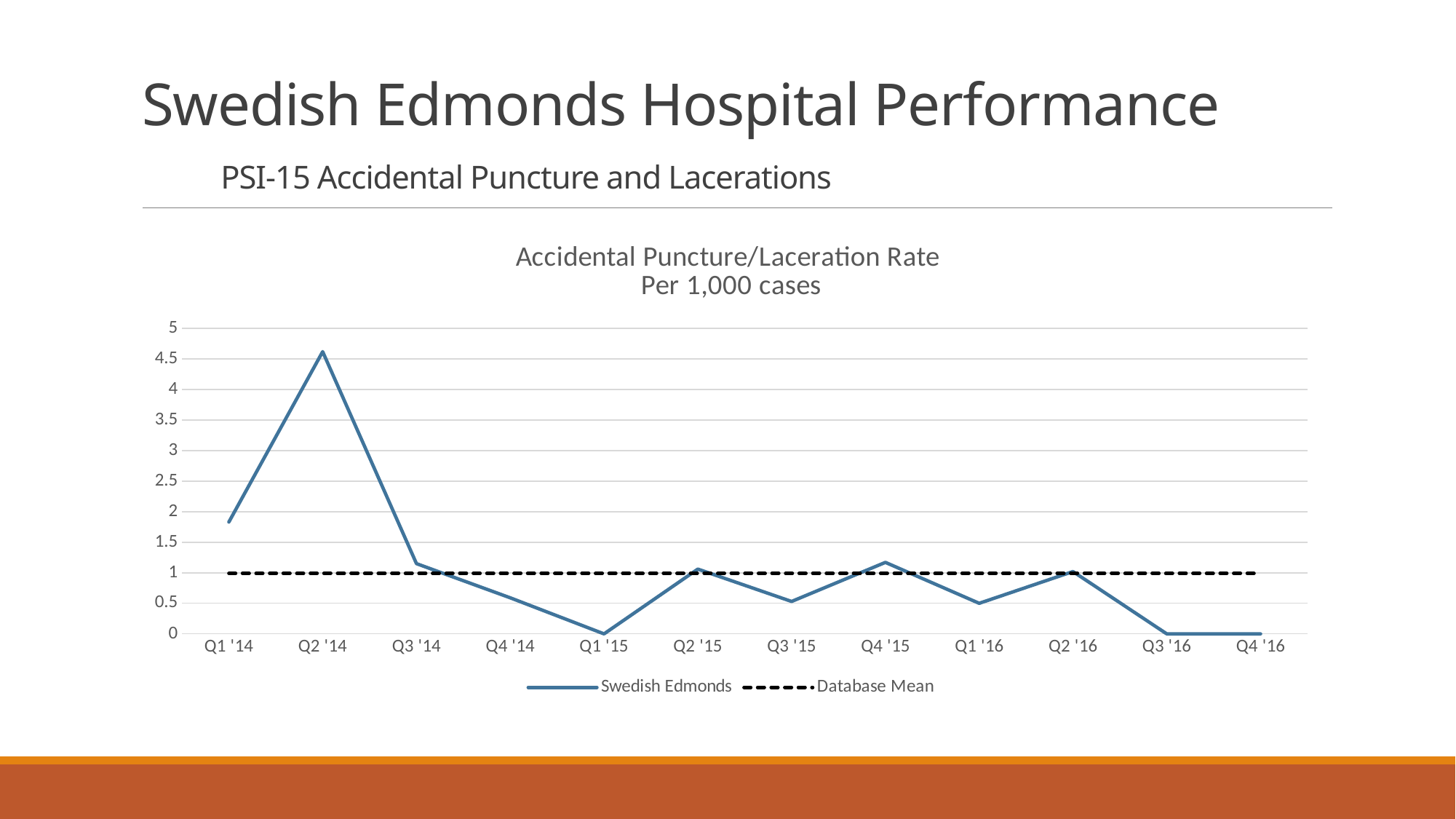
Is the Swedish Edmonds value for Q2 '14 greater or less than 4? greater Is the Swedish Edmonds value for Q1 '14 greater or less than 1.5? greater Is the Swedish Edmonds value for Q4 '14 greater or less than 1? less Does the Swedish Edmonds line rise or fall from Q2 '14 to Q1 '15? fall What kind of chart is shown on the slide? line chart What is the title of the chart? Accidental Puncture/Laceration Rate Per 1,000 cases How many series does the legend list? 2 How many quarters are plotted along the x axis? 12 In which quarter is the Swedish Edmonds rate highest? Q2 '14 Which is larger, the Swedish Edmonds value for Q1 '14 or for Q3 '15? Q1 '14 What is the Swedish Edmonds rate in Q1 '15? 0